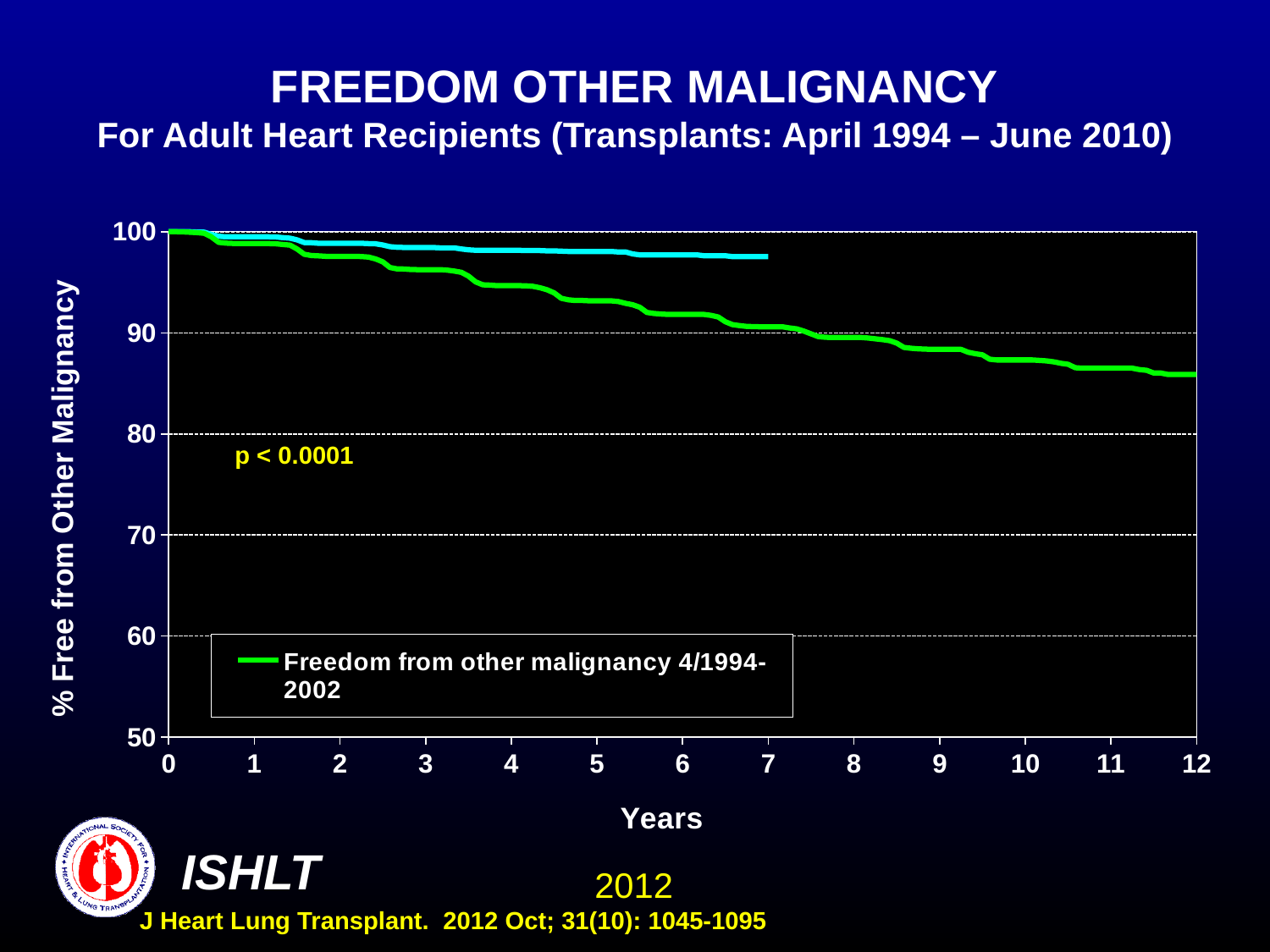
Is the value of the green line at 6 years greater or less than 90? greater Is the value of the green line at 3 years greater or less than 90? greater Is the value of the green line at 10 years greater or less than 80? greater What is the highest value shown on the y axis? 100 What kind of chart is shown on the slide? line chart What is the title of the chart? FREEDOM OTHER MALIGNANCY Does the green line rise or fall as years increase along the x axis? fall How many series does the legend list? 1 What is the label of the y axis? % Free from Other Malignancy At 6 years, which line has the higher value, the green line or the cyan line? the cyan line